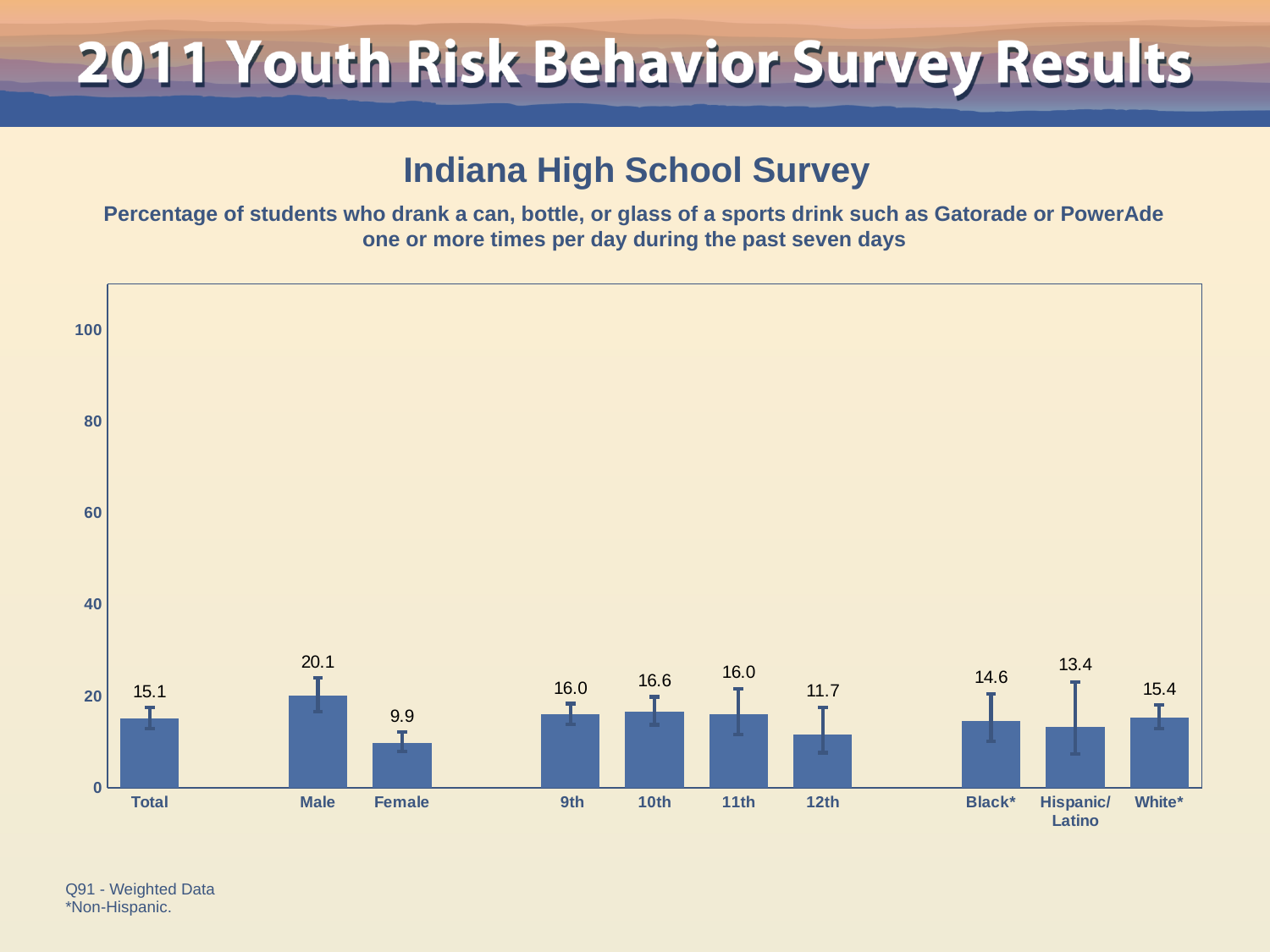
Which is larger, the value for 10th or the value for 12th? 10th What is the value for Total? 15.1 What is the difference between the values for White* and Black*? 0.8 What kind of chart is this? bar chart Which category has the highest value? Male Is the value for Male greater or less than 40? less How many categories are shown on the x axis? 10 Which category has the lowest value? Female What is the title of the chart? Indiana High School Survey What is the difference between the values for Male and Female? 10.2 What is the value for Hispanic/Latino? 13.4 What is the value for Male? 20.1